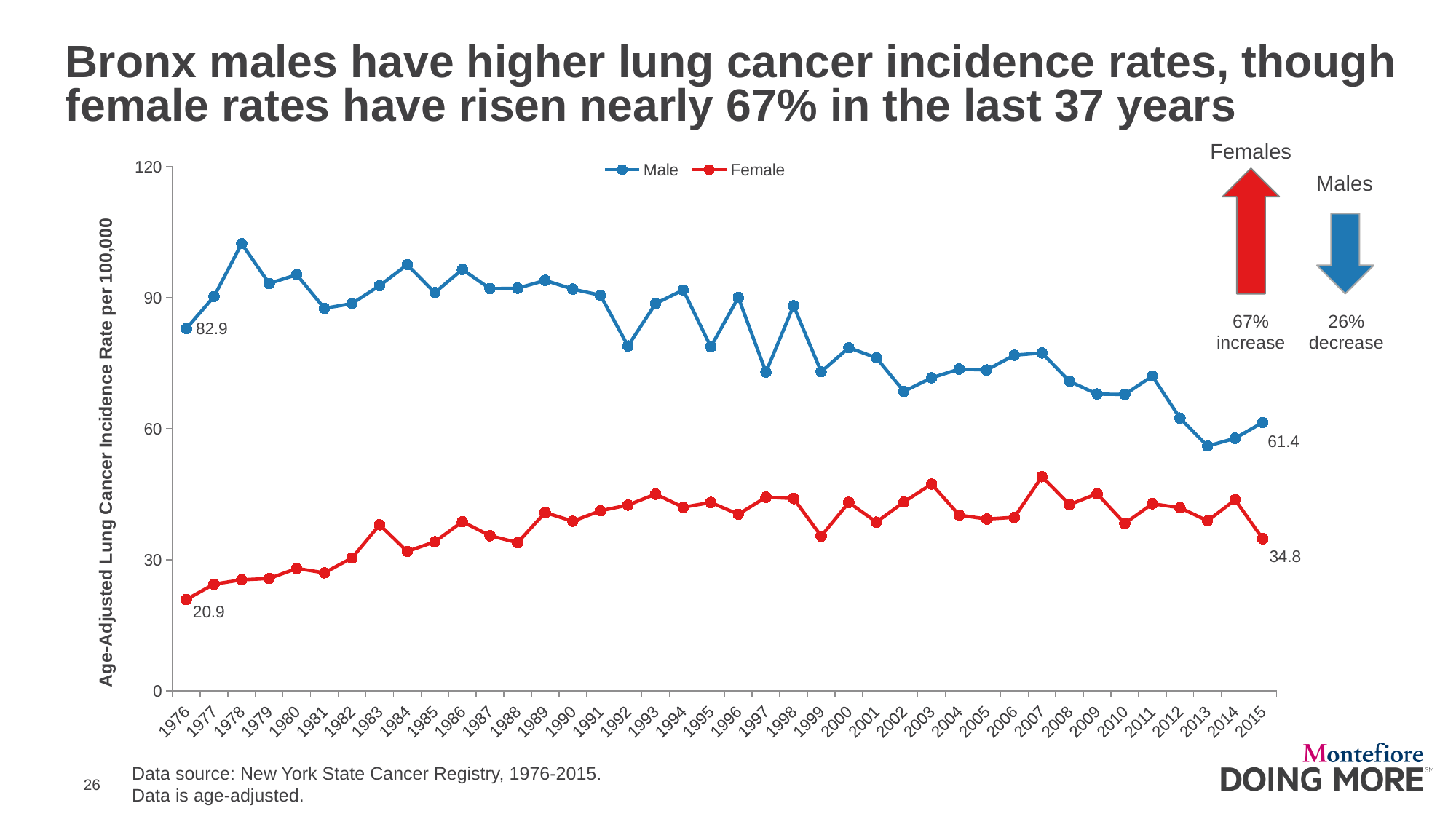
By how much did the male incidence rate fall between 1976 and 2015? 21.5 What is the male lung cancer incidence rate in 2015? 61.4 How many series does the legend list? 2 What is the female lung cancer incidence rate in 2015? 34.8 What is the male lung cancer incidence rate in 1976? 82.9 Is the male incidence rate in 1978 greater or less than 90? greater Which series has the higher value in 1976, Male or Female? Male Is the female incidence rate in 2007 greater or less than 60? less What kind of chart is shown on the slide? Line chart What is the female lung cancer incidence rate in 1976? 20.9 What is the difference between the male and female incidence rates in 2015? 26.6 In which year is the male incidence rate highest? 1978